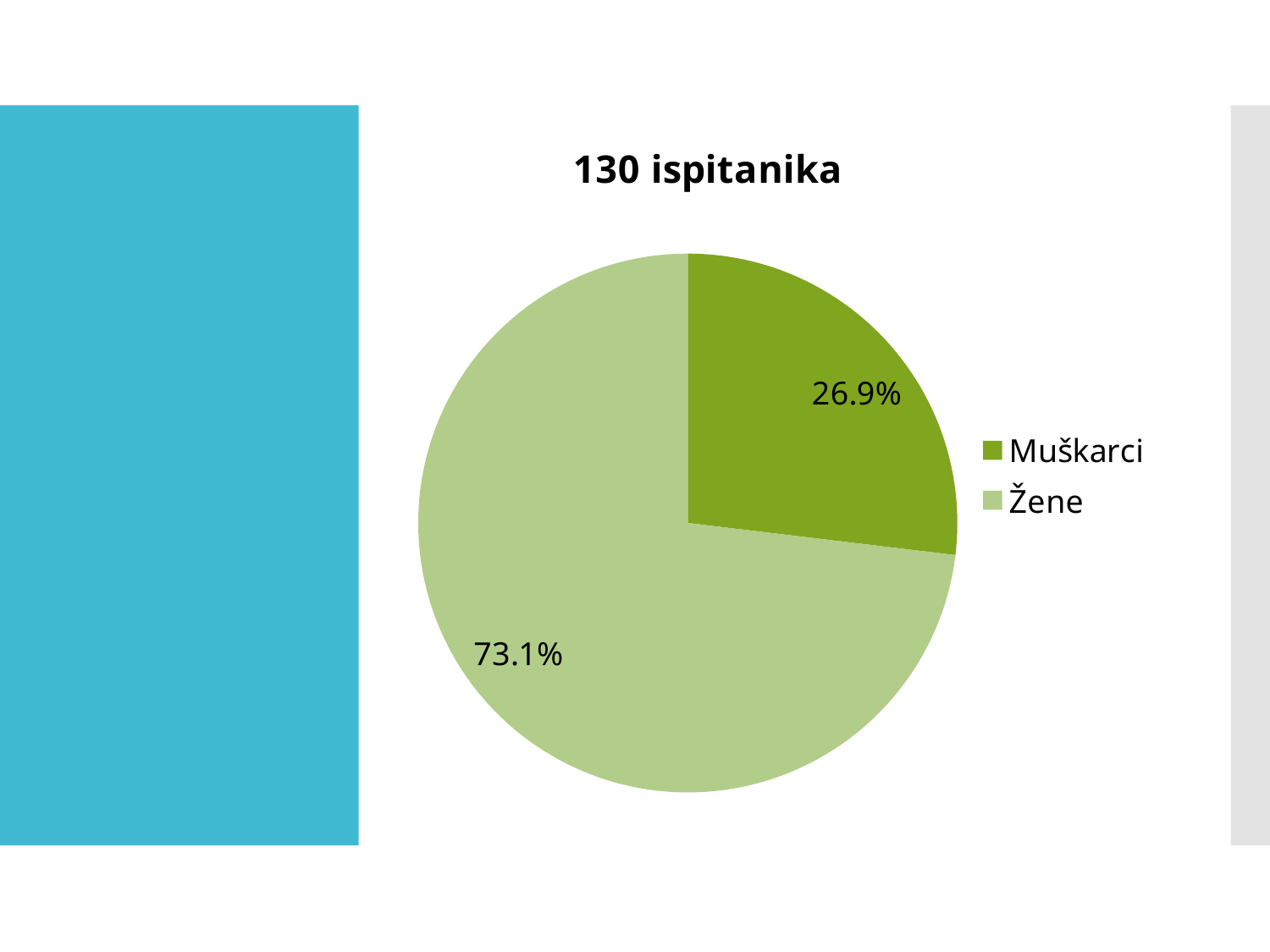
Which is larger, the share for Muškarci or the share for Žene? Žene What is the title of the chart? 130 ispitanika What is the difference in percentage points between the Žene share and the Muškarci share? 46.2 What percentage of the pie is Muškarci? 26.9% What kind of chart is shown on the slide? pie chart Which legend entry is shown in the darker green colour? Muškarci Which category has the smallest share of the pie? Muškarci What percentage of the pie is Žene? 73.1% How many slices does the pie chart have? 2 Which category has the largest share of the pie? Žene How many entries does the legend list? 2